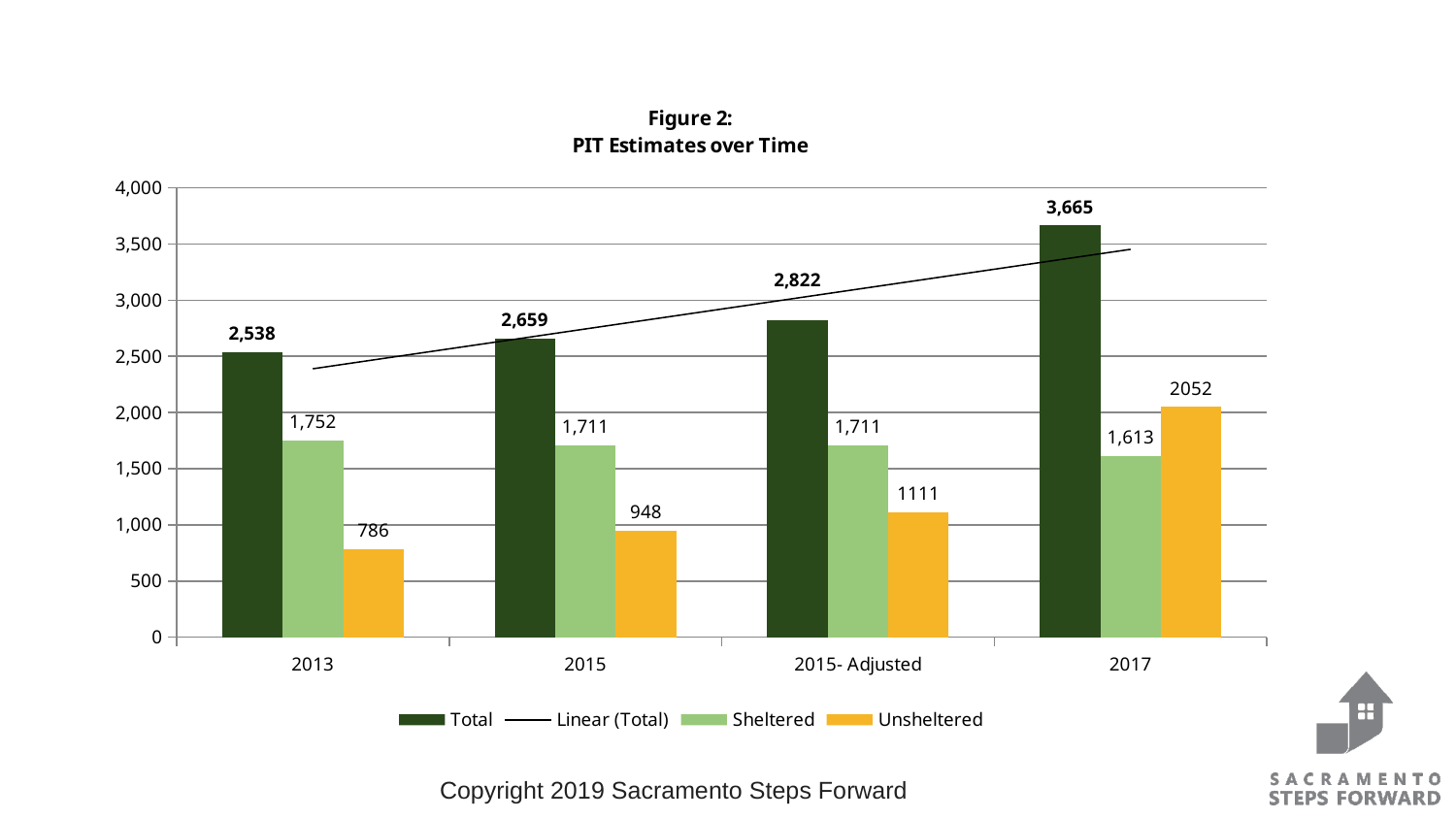
In 2017, which is larger, the Sheltered value or the Unsheltered value? Unsheltered Which category has the lowest Unsheltered value? 2013 What is the difference between the Total values for 2017 and 2015- Adjusted? 843 How many entries does the legend list? 4 Which year has the highest Total value? 2017 What is the Unsheltered value for 2013? 786 What is the Sheltered value for 2015- Adjusted? 1,711 What is the Total value for 2017? 3,665 Is the Unsheltered value for 2015 greater or less than 1,000? less What kind of chart is shown on the slide? bar chart Do the Total values rise or fall from 2013 to 2017? rise How many categories are shown on the x axis? 4